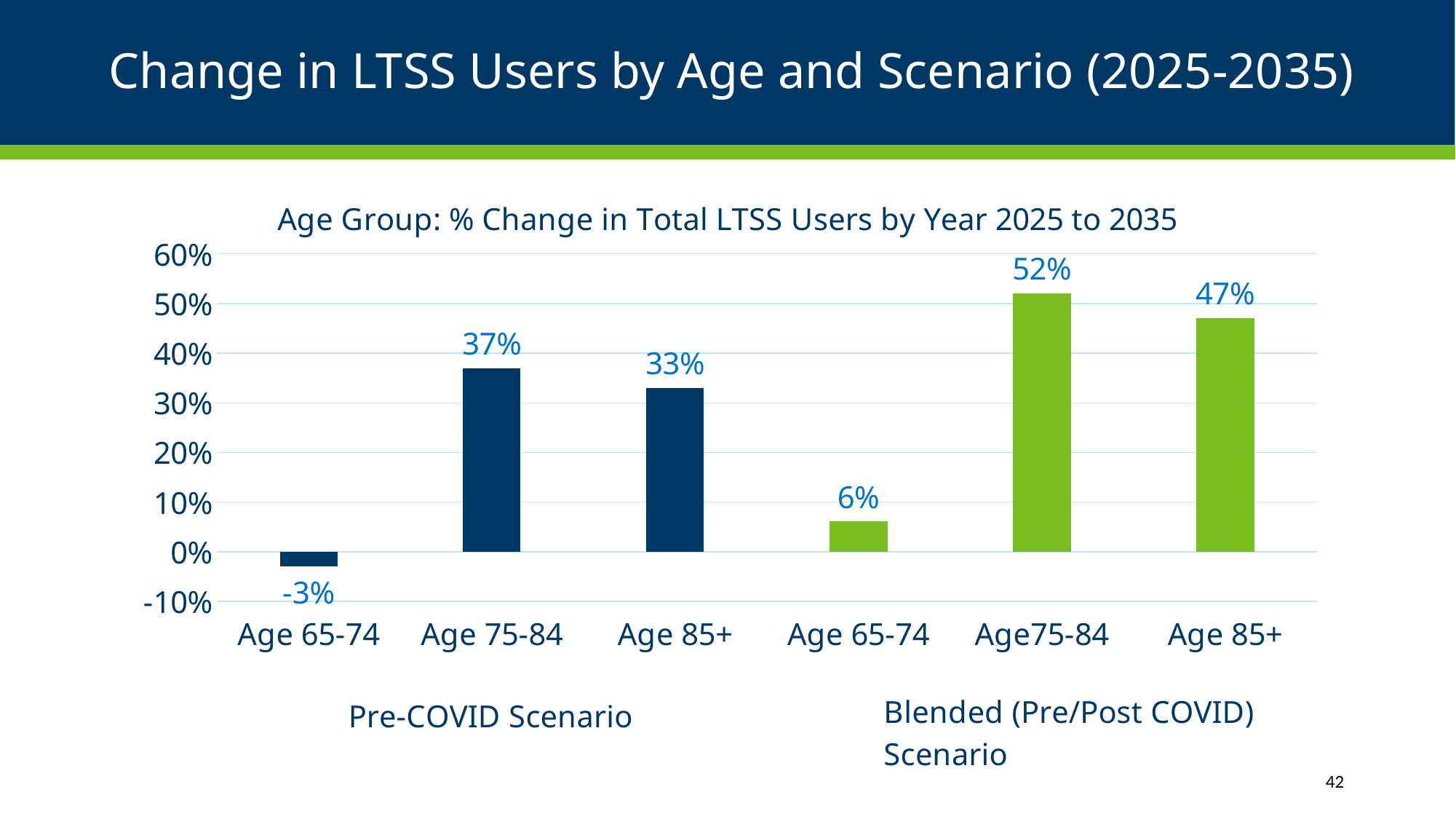
Which bar has the lowest value on the chart? Age 65-74 (Pre-COVID Scenario), -3% What is the value for Age 75-84 in the Pre-COVID Scenario? 37% What is the value for Age 65-74 in the Pre-COVID Scenario? -3% How many bars are plotted on the chart? 6 What is the value for Age 65-74 in the Blended (Pre/Post COVID) Scenario? 6% What is the difference between the Age 85+ values in the Blended Scenario and the Pre-COVID Scenario? 14 percentage points Which bar has the highest value on the chart? Age75-84 (Blended Scenario), 52% What is the value for Age 85+ in the Blended (Pre/Post COVID) Scenario? 47% Which is larger: Age 75-84 in the Pre-COVID Scenario or Age 85+ in the Pre-COVID Scenario? Age 75-84 in the Pre-COVID Scenario Is the value for Age75-84 in the Blended Scenario greater or less than 50%? greater What is the title of the chart? Age Group: % Change in Total LTSS Users by Year 2025 to 2035 What type of chart is shown on the slide? Bar chart